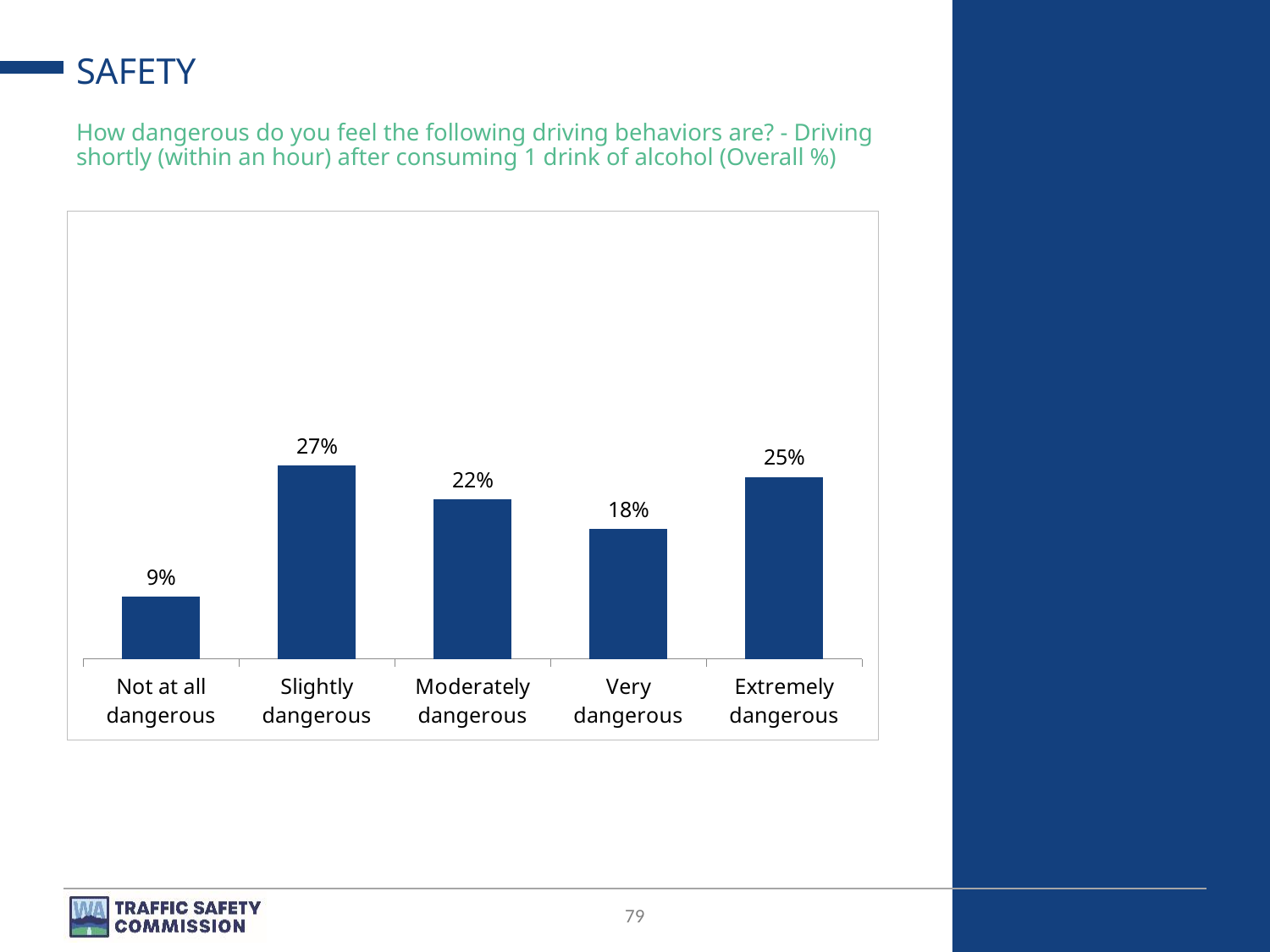
What is the value for "Slightly dangerous"? 27% What is the difference between the values for "Slightly dangerous" and "Very dangerous"? 9% What is the value for "Extremely dangerous"? 25% What kind of chart is shown on the slide? Bar chart What is the value for "Very dangerous"? 18% Which is larger, the value for "Extremely dangerous" or the value for "Moderately dangerous"? Extremely dangerous What percentage of respondents said driving shortly after consuming 1 drink of alcohol is "Not at all dangerous"? 9% Which category has the highest value? Slightly dangerous How many categories are shown on the chart? 5 Which category has the lowest value? Not at all dangerous What is the value for "Moderately dangerous"? 22% What driving behavior does the chart's title ask about? Driving shortly (within an hour) after consuming 1 drink of alcohol